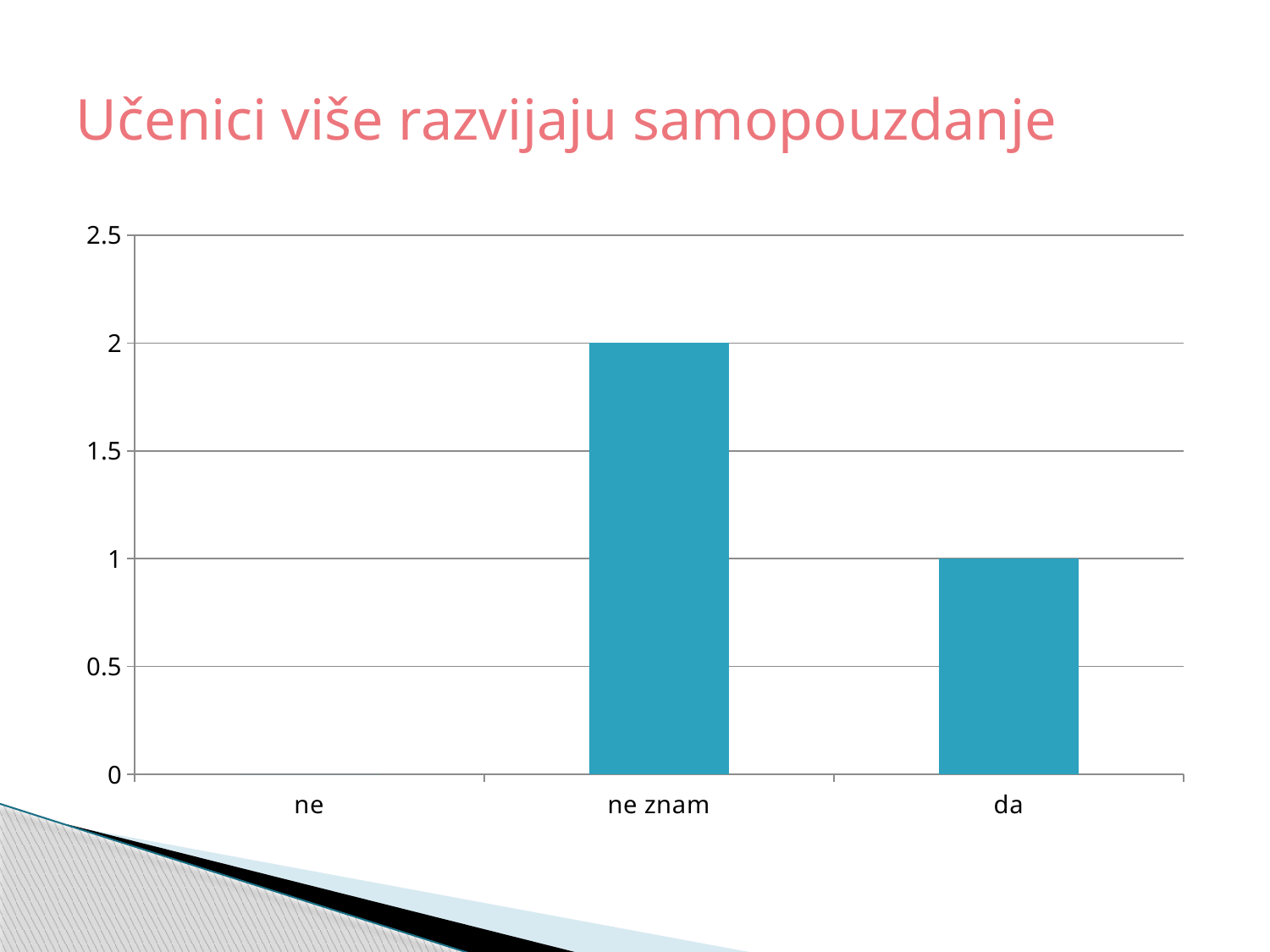
What kind of chart is shown on the slide? bar chart Which category has the highest value? ne znam Which category has the lowest value? ne How many categories are shown on the x axis? 3 What is the difference between the values for "ne znam" and "da"? 1 Is the value for "ne znam" greater or less than 1.5? greater What is the title of the slide? Učenici više razvijaju samopouzdanje Which is larger, the value for "da" or the value for "ne znam"? ne znam Is the value for "da" greater or less than 1.5? less What is the value for "ne"? 0 What is the value for "ne znam"? 2 What is the value for "da"? 1